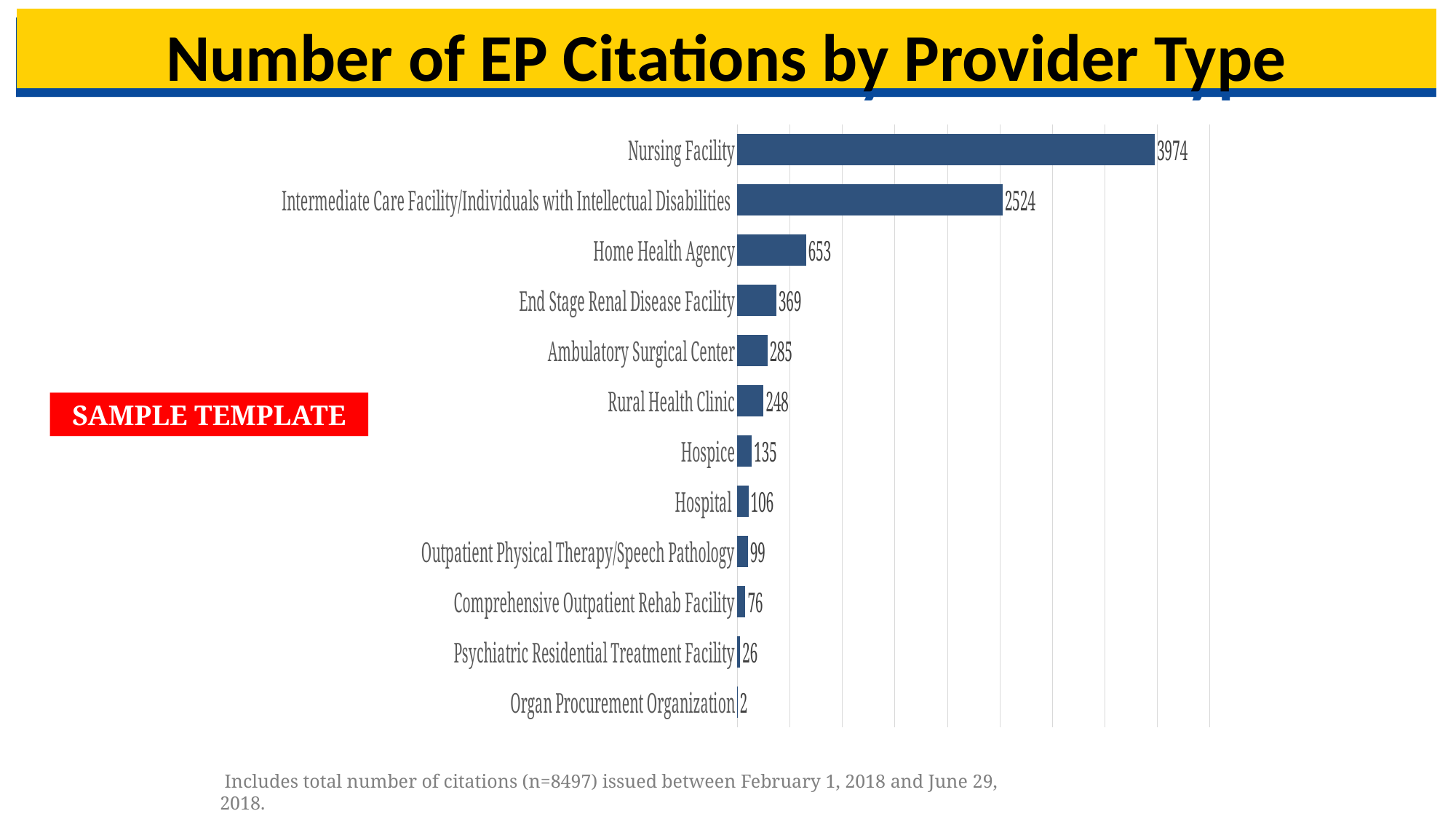
What is the difference in EP citations between Nursing Facility and Intermediate Care Facility/Individuals with Intellectual Disabilities? 1450 Which has more EP citations, Comprehensive Outpatient Rehab Facility or Outpatient Physical Therapy/Speech Pathology? Outpatient Physical Therapy/Speech Pathology What is the difference in EP citations between End Stage Renal Disease Facility and Ambulatory Surgical Center? 84 How many provider types are shown in the chart? 12 What is the title of the chart on the slide? Number of EP Citations by Provider Type What is the number of EP citations for Home Health Agency? 653 Which has more EP citations, Rural Health Clinic or Hospital? Rural Health Clinic How many EP citations does the chart show for Hospice? 135 How many EP citations were issued to Nursing Facilities? 3974 Which provider type has the lowest number of EP citations? Organ Procurement Organization What type of chart is shown on the slide? Bar chart Which provider type has the highest number of EP citations? Nursing Facility